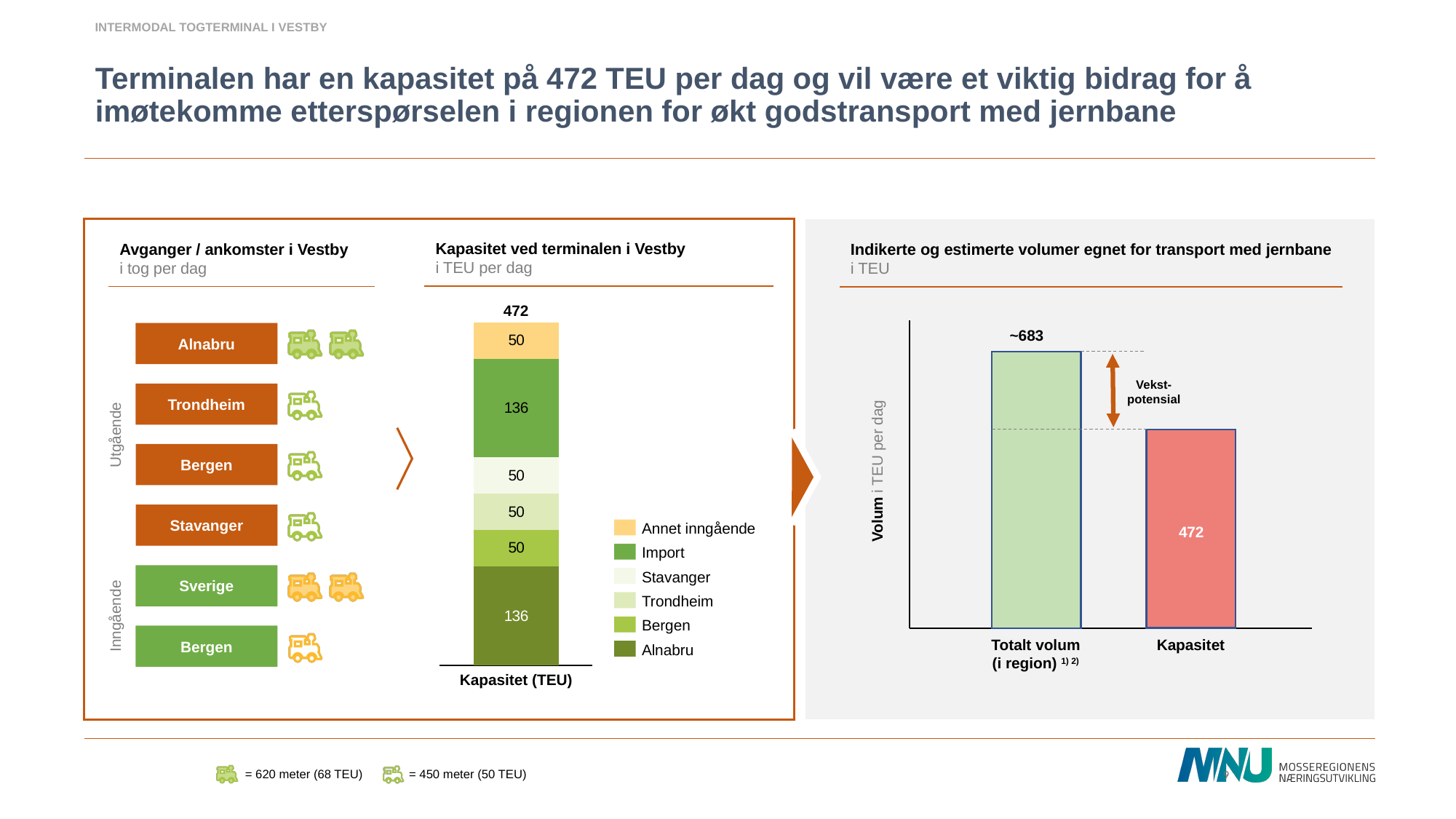
In the 'Kapasitet ved terminalen i Vestby' chart, what is the value of the Alnabru segment? 136 In the 'Indikerte og estimerte volumer egnet for transport med jernbane' chart, what is the value of the Kapasitet bar? 472 In the 'Kapasitet ved terminalen i Vestby' chart, what is the value of the Import segment? 136 In the 'Indikerte og estimerte volumer egnet for transport med jernbane' chart, how many bars are shown? 2 In the 'Kapasitet ved terminalen i Vestby' chart, how many segments does the legend list? 6 In the 'Kapasitet ved terminalen i Vestby' chart, what is the total capacity shown at the top of the stacked bar? 472 In the 'Kapasitet ved terminalen i Vestby' chart, what is the value of the Stavanger segment? 50 In the 'Kapasitet ved terminalen i Vestby' chart, which is larger, the Alnabru segment or the Trondheim segment? Alnabru In the 'Kapasitet ved terminalen i Vestby' chart, what is the value of the Annet inngående segment? 50 What kind of chart is 'Kapasitet ved terminalen i Vestby'? Stacked bar chart In the 'Indikerte og estimerte volumer egnet for transport med jernbane' chart, which bar is higher, Totalt volum (i region) or Kapasitet? Totalt volum (i region) In the 'Kapasitet ved terminalen i Vestby' chart, what is the difference between the Import segment and the Bergen segment? 86